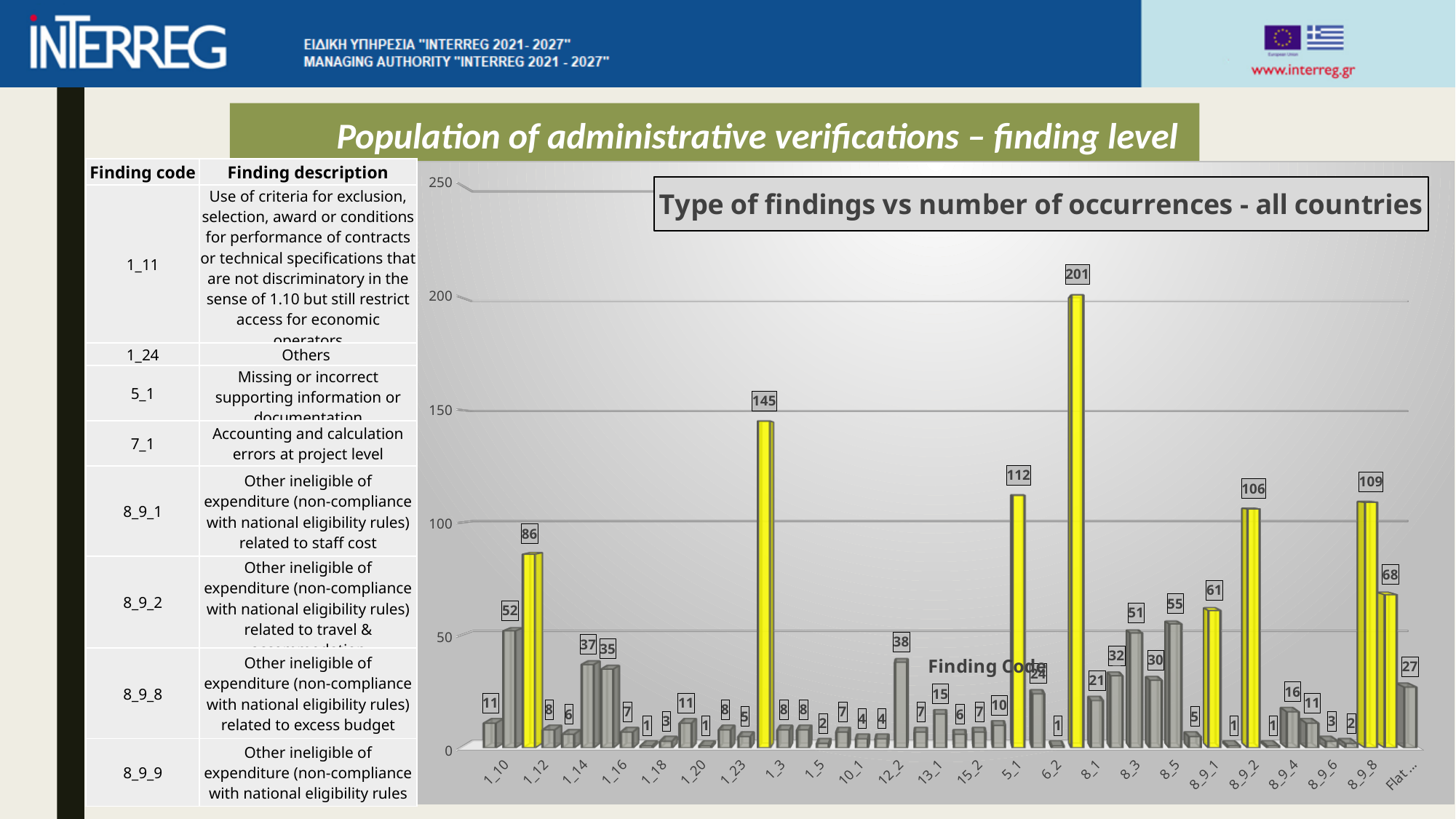
What is the title of the chart? Type of findings vs number of occurrences - all countries What is the number of occurrences for finding code 8_9_2? 106 What is the difference between the highest bar (201) and the second highest bar (145)? 56 Which has more occurrences, finding code 8_9_2 or finding code 8_9_8? 8_9_8 What is the number of occurrences for finding code 8_9_1? 61 What is the number of occurrences for finding code 8_9_8? 109 What type of chart is shown on the slide? bar chart What is the highest value shown in the chart? 201 Is the value for finding code 5_1 greater or less than 100? greater What is the number of occurrences for finding code 1_10? 52 What is the number of occurrences for finding code 5_1? 112 What colour are the highlighted bars in the chart? yellow